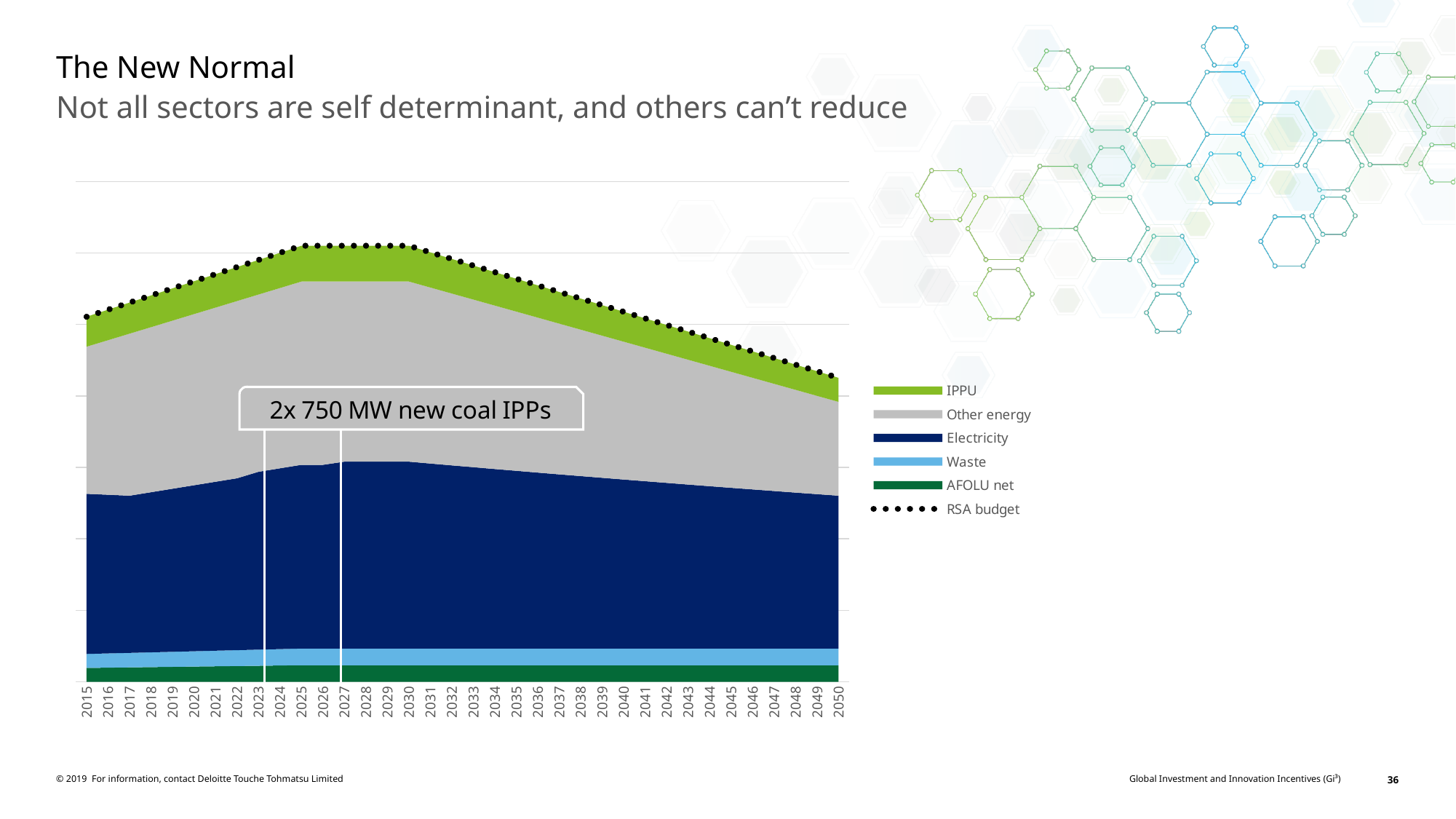
Which series is shown in light green at the top of the stack? IPPU Does the RSA budget line rise or fall between 2015 and 2025? Rise What is the first year shown on the x axis? 2015 Which series is larger in 2040, Other energy or IPPU? Other energy What kind of chart is shown on the slide? Stacked area chart Which series occupies the largest area of the stacked chart? Electricity What is the last year shown on the x axis? 2050 Does the RSA budget line rise or fall between 2030 and 2050? Fall How many series does the legend list? 6 What does the annotation box on the chart say? 2x 750 MW new coal IPPs How many years are shown along the x axis? 36 Which series is drawn as a dotted line rather than a filled area? RSA budget